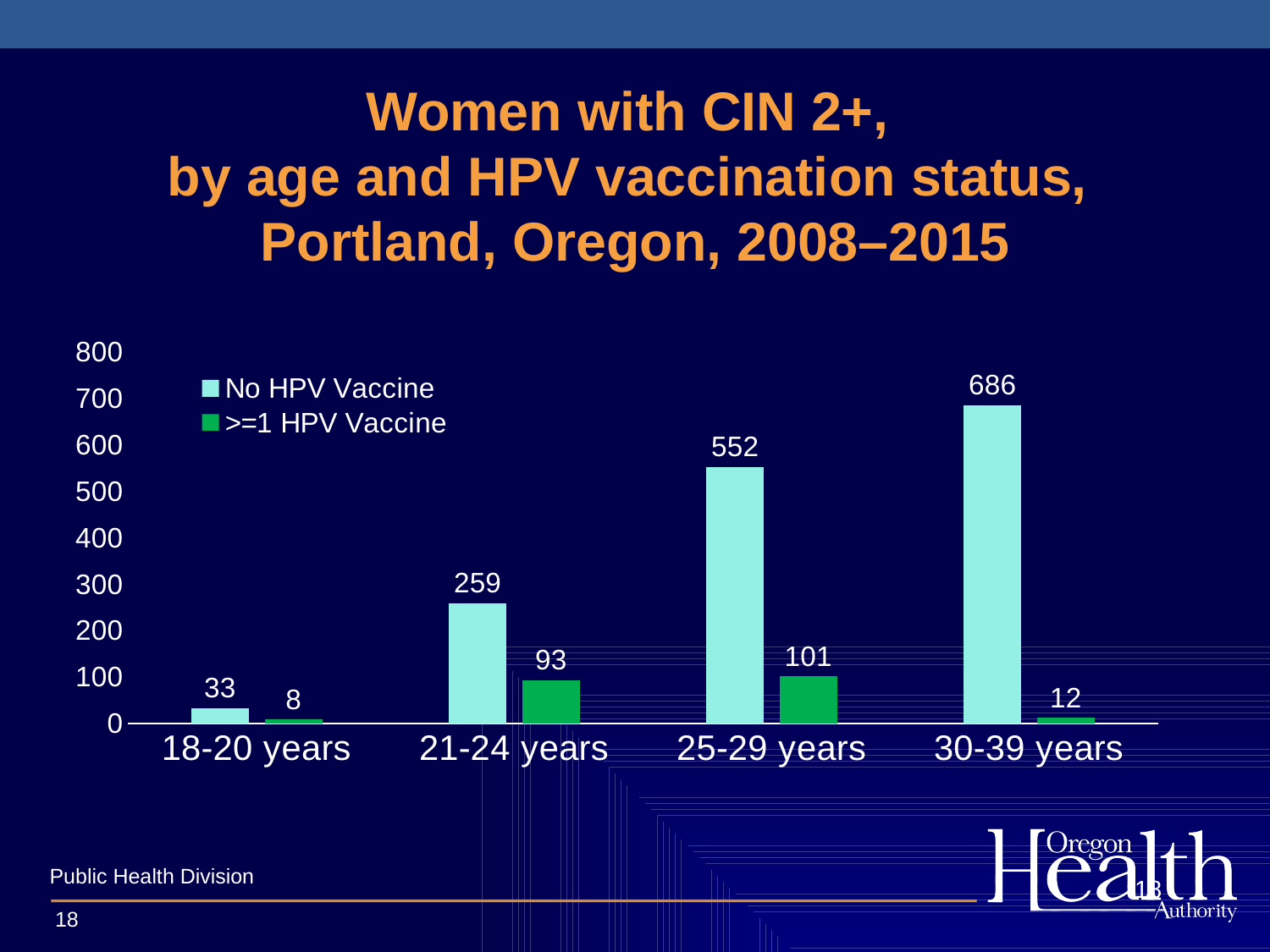
What is the difference between the No HPV Vaccine and >=1 HPV Vaccine values in the 25-29 years group? 451 Which age group has the lowest value for >=1 HPV Vaccine? 18-20 years What is the value for >=1 HPV Vaccine in the 21-24 years group? 93 How many series does the legend list? 2 What is the number of women with CIN 2+ and no HPV vaccine in the 25-29 years group? 552 What kind of chart is shown on the slide? bar chart What is the value for >=1 HPV Vaccine in the 30-39 years group? 12 Is the No HPV Vaccine value for 21-24 years greater or less than 300? less Do the No HPV Vaccine values rise or fall as age increases along the x axis? rise Which is larger: the >=1 HPV Vaccine value for 21-24 years or for 25-29 years? 25-29 years Which age group has the highest value for No HPV Vaccine? 30-39 years How many age groups are shown on the x axis? 4